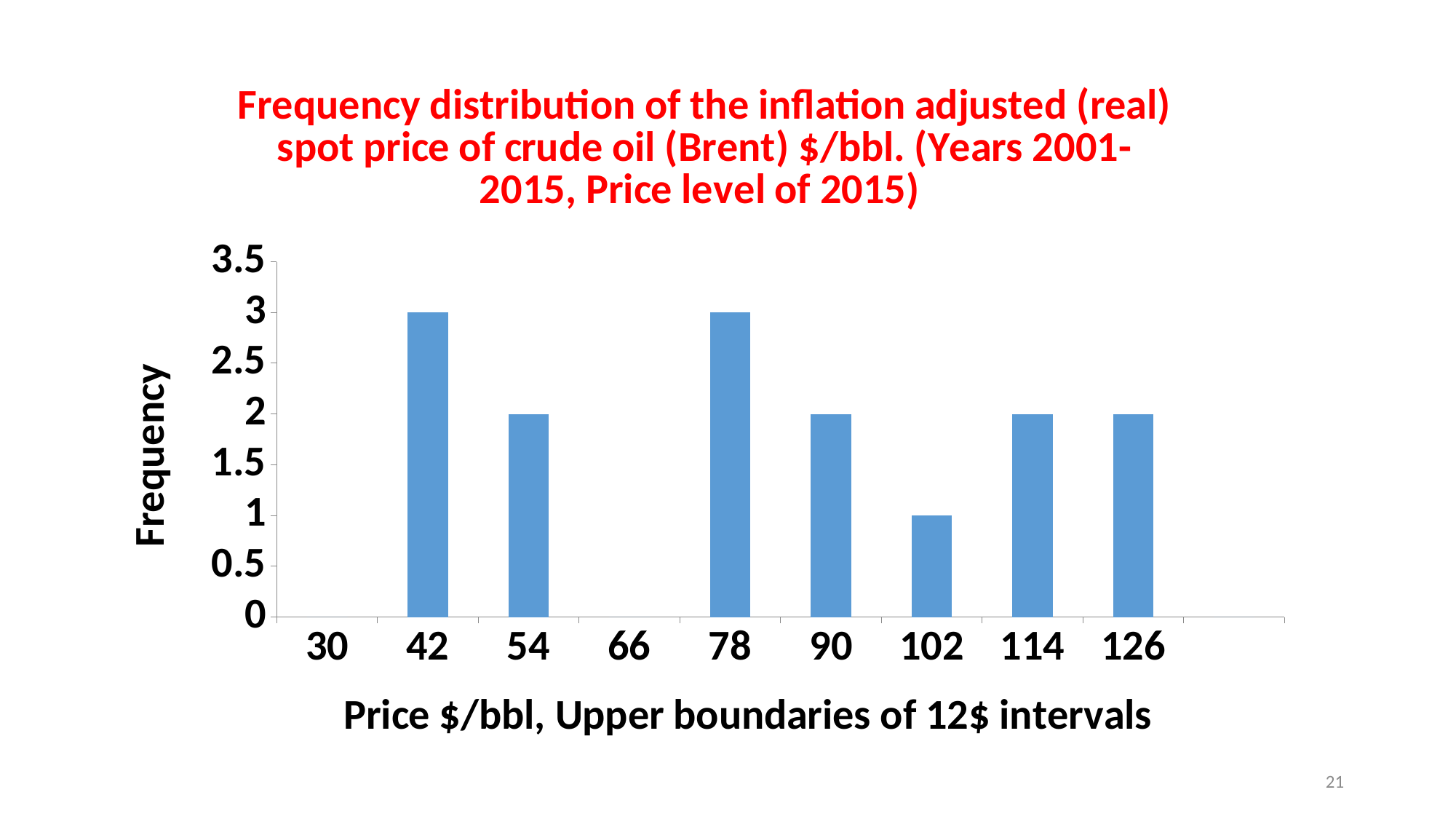
What is the label of the y axis? Frequency Which two price intervals share the highest frequency? 42 and 78 What is the frequency for the price interval with upper boundary 66? 0 What is the difference between the frequency at 78 and the frequency at 102? 2 What is the frequency for the price interval with upper boundary 102? 1 What is the frequency for the price interval with upper boundary 42? 3 How many price intervals are labelled on the x axis? 9 What kind of chart is shown on the slide? bar chart How many bars with a non-zero frequency are shown? 7 What is the frequency for the price interval with upper boundary 90? 2 Among the intervals with a visible bar, which has the lowest frequency? 102 Which has a higher frequency, the interval at 54 or the interval at 102? 54